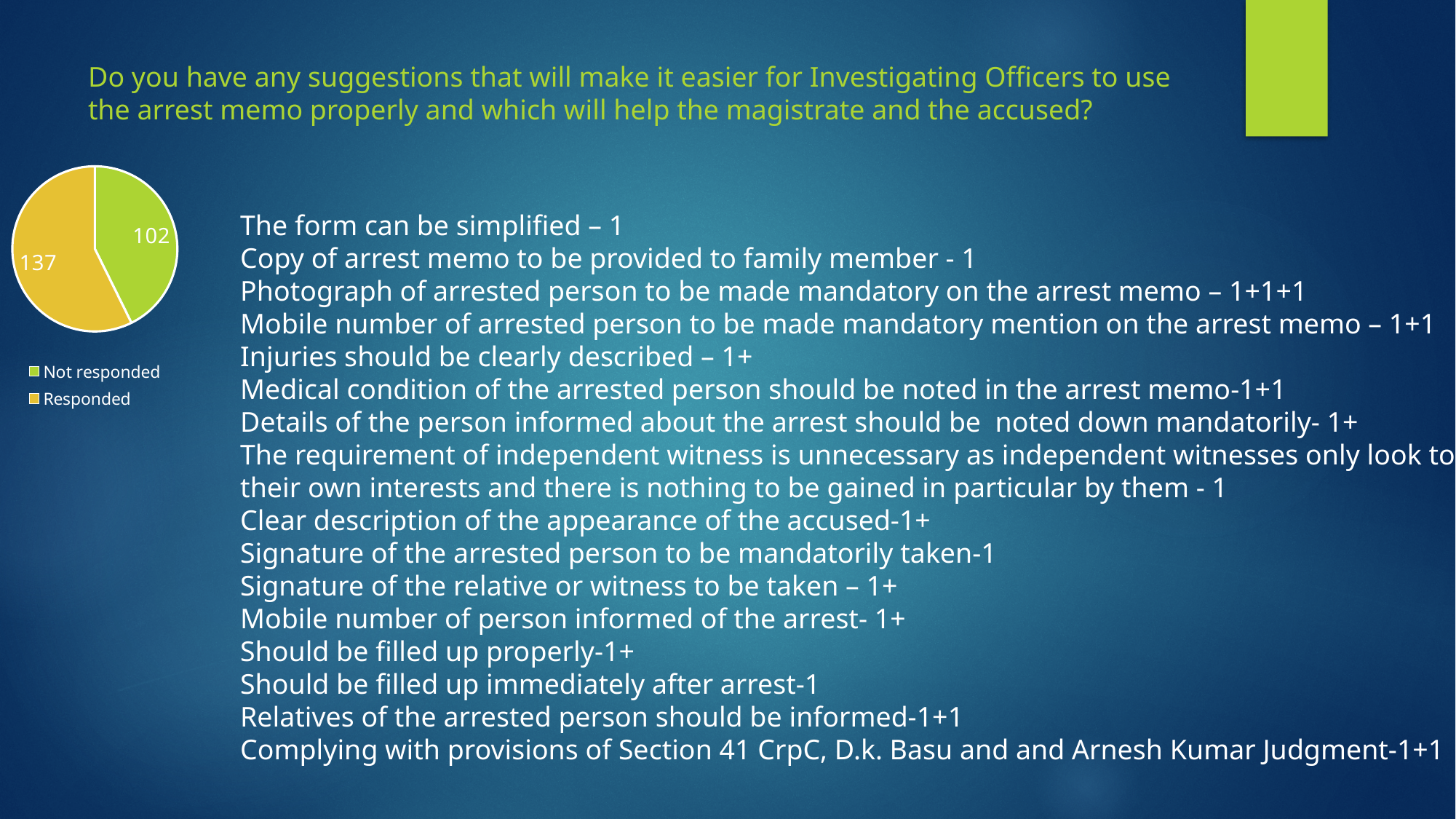
Which is larger in the pie chart, Responded or Not responded? Responded How many entries does the pie chart legend list? 2 What colour is the Not responded slice in the pie chart? green Which slice of the pie chart is the largest? Responded What is the value for Responded in the pie chart? 137 What is the total of the two values shown in the pie chart? 239 Which slice of the pie chart is the smallest? Not responded What is the difference between the Responded and Not responded values in the pie chart? 35 How many slices does the pie chart have? 2 What is the value for Not responded in the pie chart? 102 What kind of chart is shown on the slide? pie chart